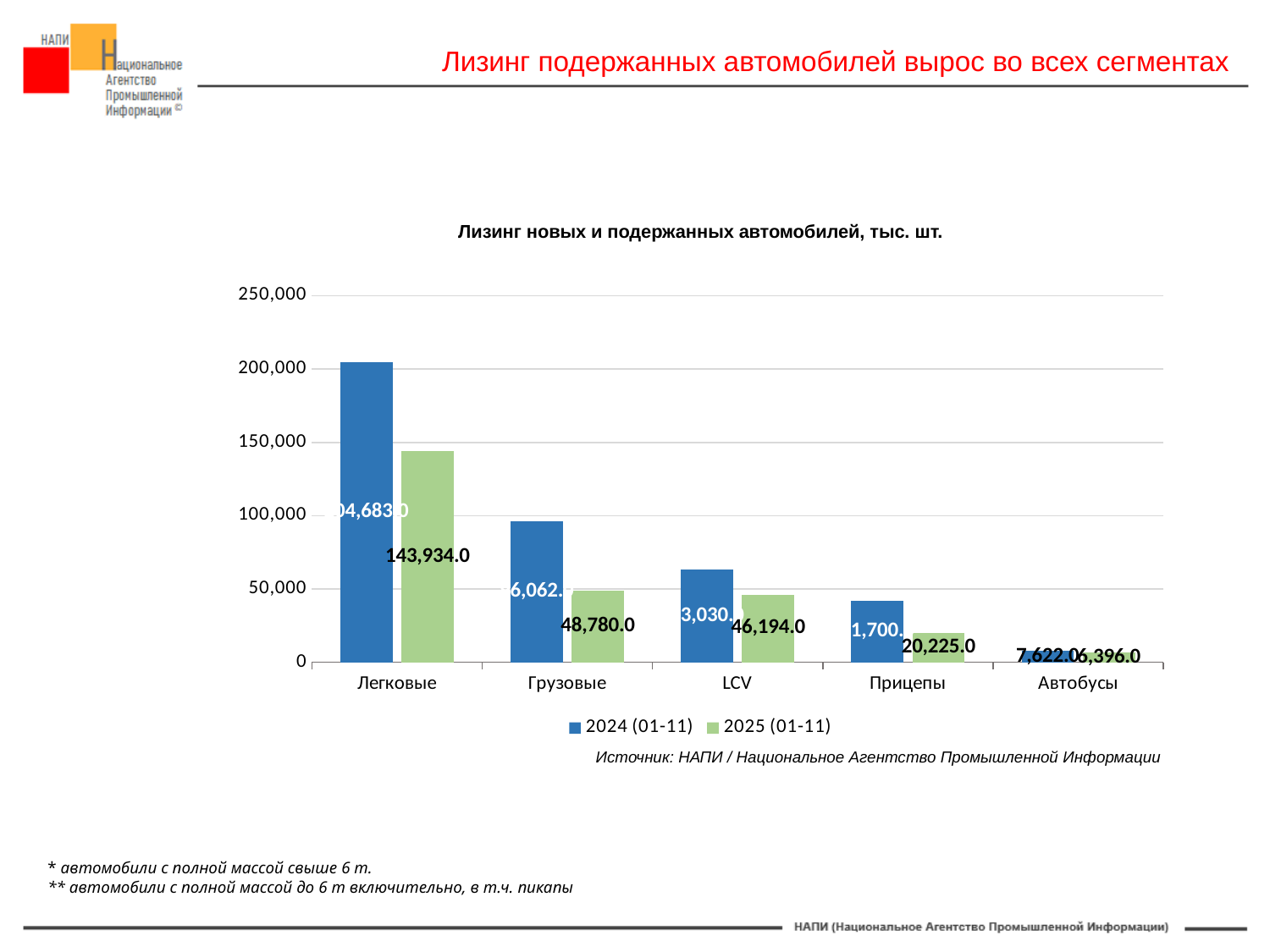
What is the value for Грузовые in the 2025 (01-11) series? 48,780.0 What is the difference between the 2025 (01-11) values for Грузовые and LCV? 2,586.0 Is the 2024 (01-11) value for Грузовые greater or less than 100,000? less What is the value for Легковые in the 2025 (01-11) series? 143,934.0 What is the value for LCV in the 2025 (01-11) series? 46,194.0 What is the value for Автобусы in the 2025 (01-11) series? 6,396.0 Which category has the lowest value in the 2025 (01-11) series? Автобусы Is the 2024 (01-11) value for Легковые greater or less than 200,000? greater What is the value for Прицепы in the 2025 (01-11) series? 20,225.0 How many series does the legend list? 2 Which category has the highest value in the 2025 (01-11) series? Легковые For Легковые, which series has the larger value, 2024 (01-11) or 2025 (01-11)? 2024 (01-11)